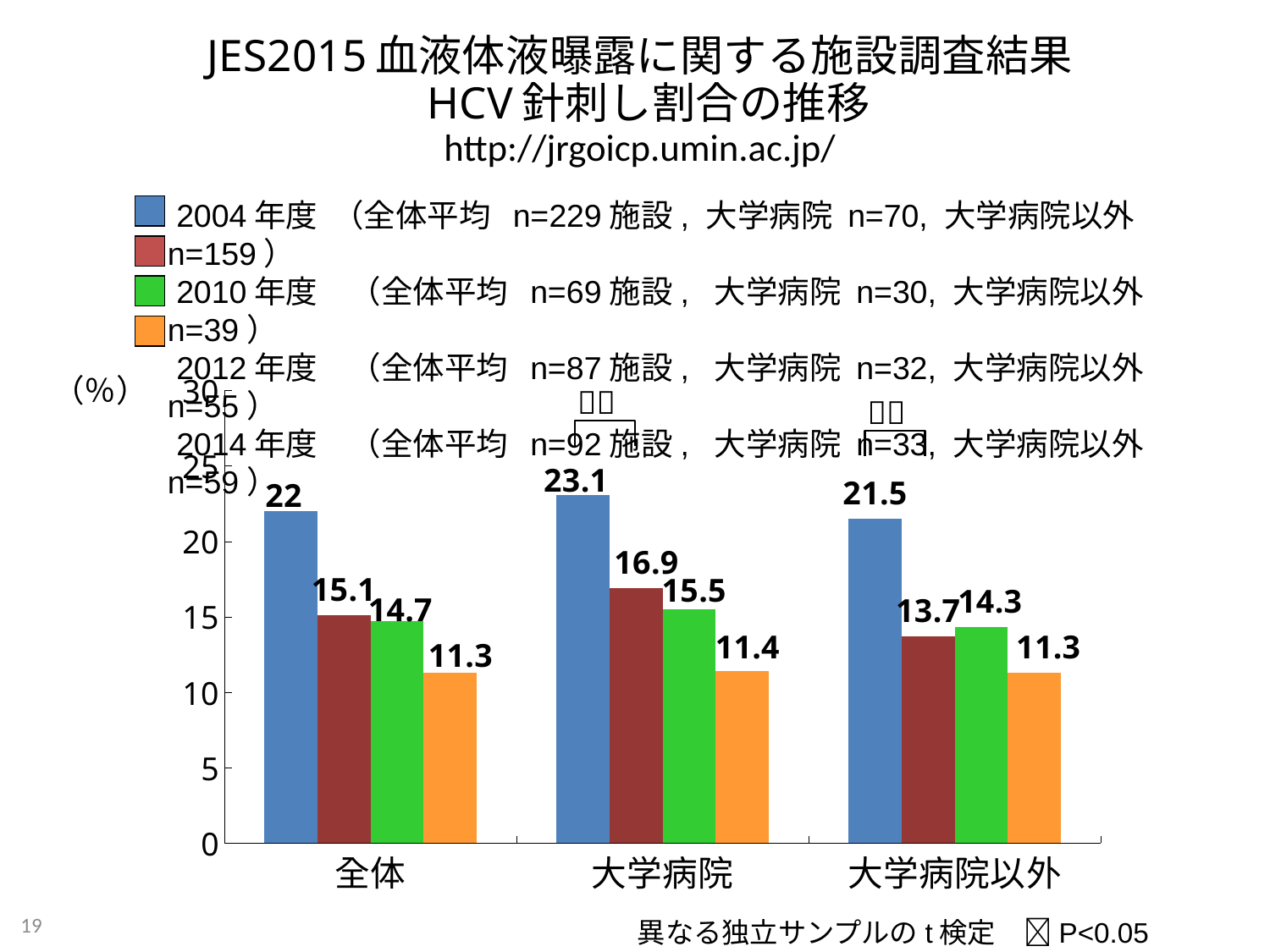
What is the value for 2004年度 in the 全体 category? 22 Within the 大学病院 category, do the values rise or fall from 2004年度 to 2014年度? fall What is the value for 2010年度 in the 大学病院 category? 16.9 What is the difference between the 2004年度 and 2014年度 values in the 大学病院 category? 11.7 What is the value for 2012年度 in the 全体 category? 14.7 How many categories are shown on the x axis? 3 What is the value for 2014年度 in the 大学病院以外 category? 11.3 Which category has the highest value for 2004年度? 大学病院 Which category has the lowest value for 2010年度? 大学病院以外 What kind of chart is shown on the slide? bar chart How many series does the legend list? 4 In the 大学病院以外 category, which is larger: the 2010年度 value or the 2012年度 value? 2012年度